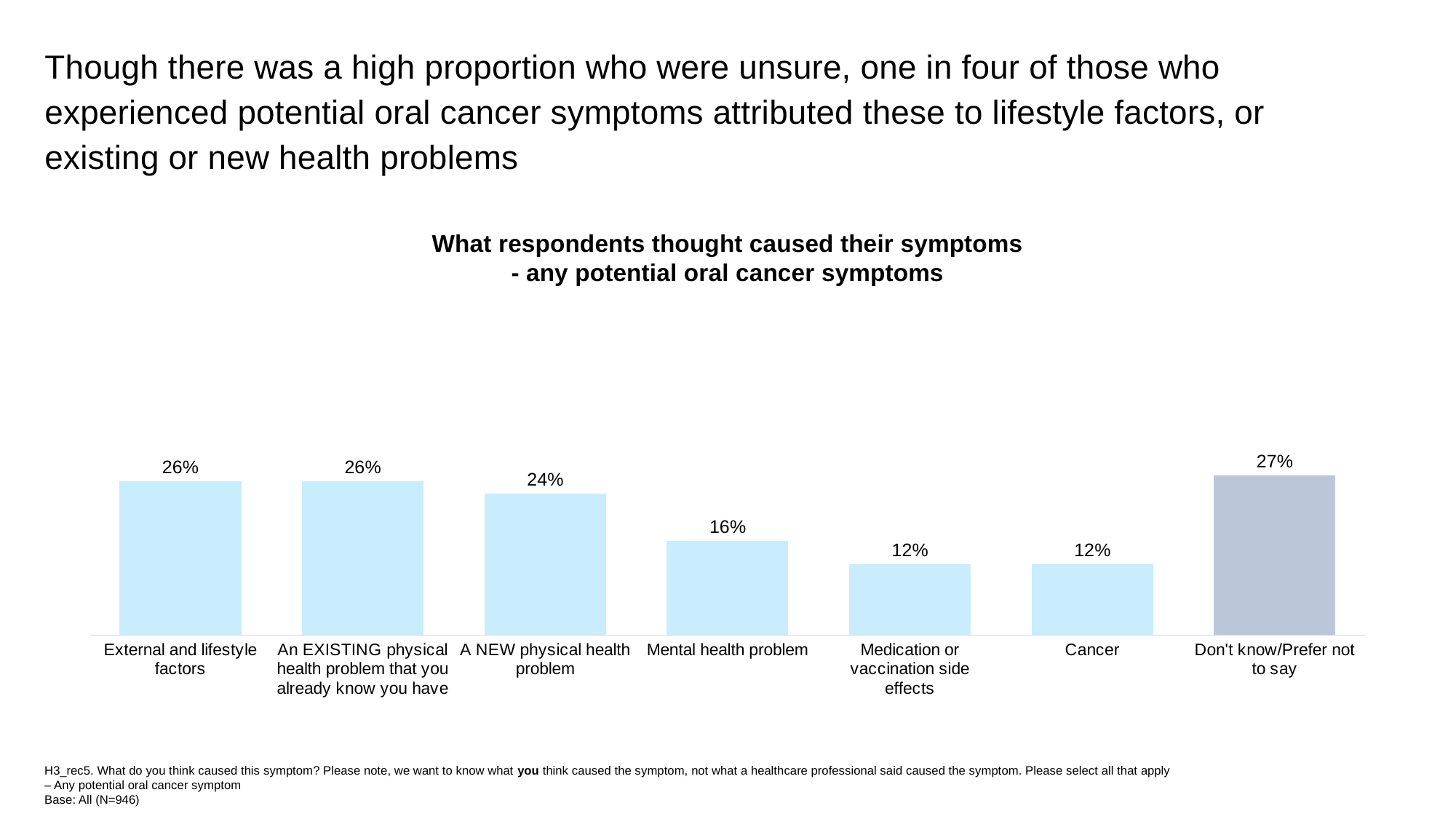
Which category has the highest value? Don't know/Prefer not to say What is the value for 'A NEW physical health problem'? 24% What is the value for 'Cancer'? 12% Which is larger: 'A NEW physical health problem' or 'Medication or vaccination side effects'? A NEW physical health problem Which bar is shaded a different colour (grey) from the others? Don't know/Prefer not to say What is the value for 'Mental health problem'? 16% What kind of chart is shown on the slide? Bar chart What is the difference between 'External and lifestyle factors' and 'Cancer'? 14 percentage points What percentage of respondents attributed their symptoms to external and lifestyle factors? 26% How many categories are shown in the chart? 7 What is the title of the chart? What respondents thought caused their symptoms - any potential oral cancer symptoms What is the difference between 'Don't know/Prefer not to say' and 'Mental health problem'? 11 percentage points